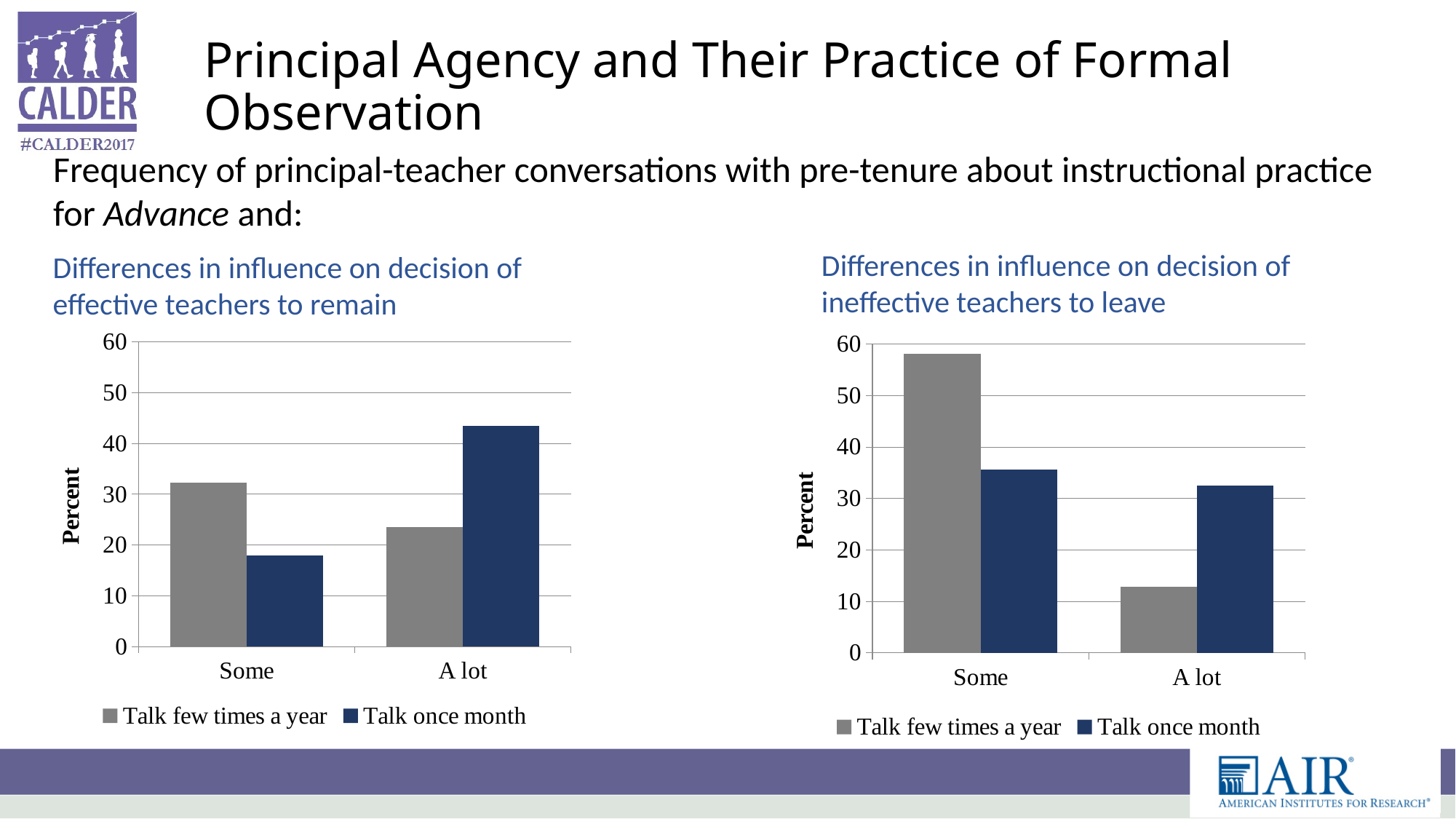
In the left chart, 'Differences in influence on decision of effective teachers to remain', which series has the larger value at 'Some'? Talk few times a year In the right chart, 'Differences in influence on decision of ineffective teachers to leave', is the value for 'Talk few times a year' at 'A lot' greater or less than 20? less What type of chart is the left chart, 'Differences in influence on decision of effective teachers to remain'? bar chart What is the y-axis label of the right chart, 'Differences in influence on decision of ineffective teachers to leave'? Percent How many categories are shown on the x axis of the left chart, 'Differences in influence on decision of effective teachers to remain'? 2 In the right chart, 'Differences in influence on decision of ineffective teachers to leave', which bar is the shortest? Talk few times a year at A lot In the right chart, 'Differences in influence on decision of ineffective teachers to leave', which bar is the tallest? Talk few times a year at Some In the left chart, 'Differences in influence on decision of effective teachers to remain', is the value for 'Talk once month' at 'Some' greater or less than 20? less How many series does the legend list in the right chart, 'Differences in influence on decision of ineffective teachers to leave'? 2 In the left chart, 'Differences in influence on decision of effective teachers to remain', is the value for 'Talk once month' at 'A lot' greater or less than 40? greater In the left chart, 'Differences in influence on decision of effective teachers to remain', which series has the larger value at 'A lot'? Talk once month